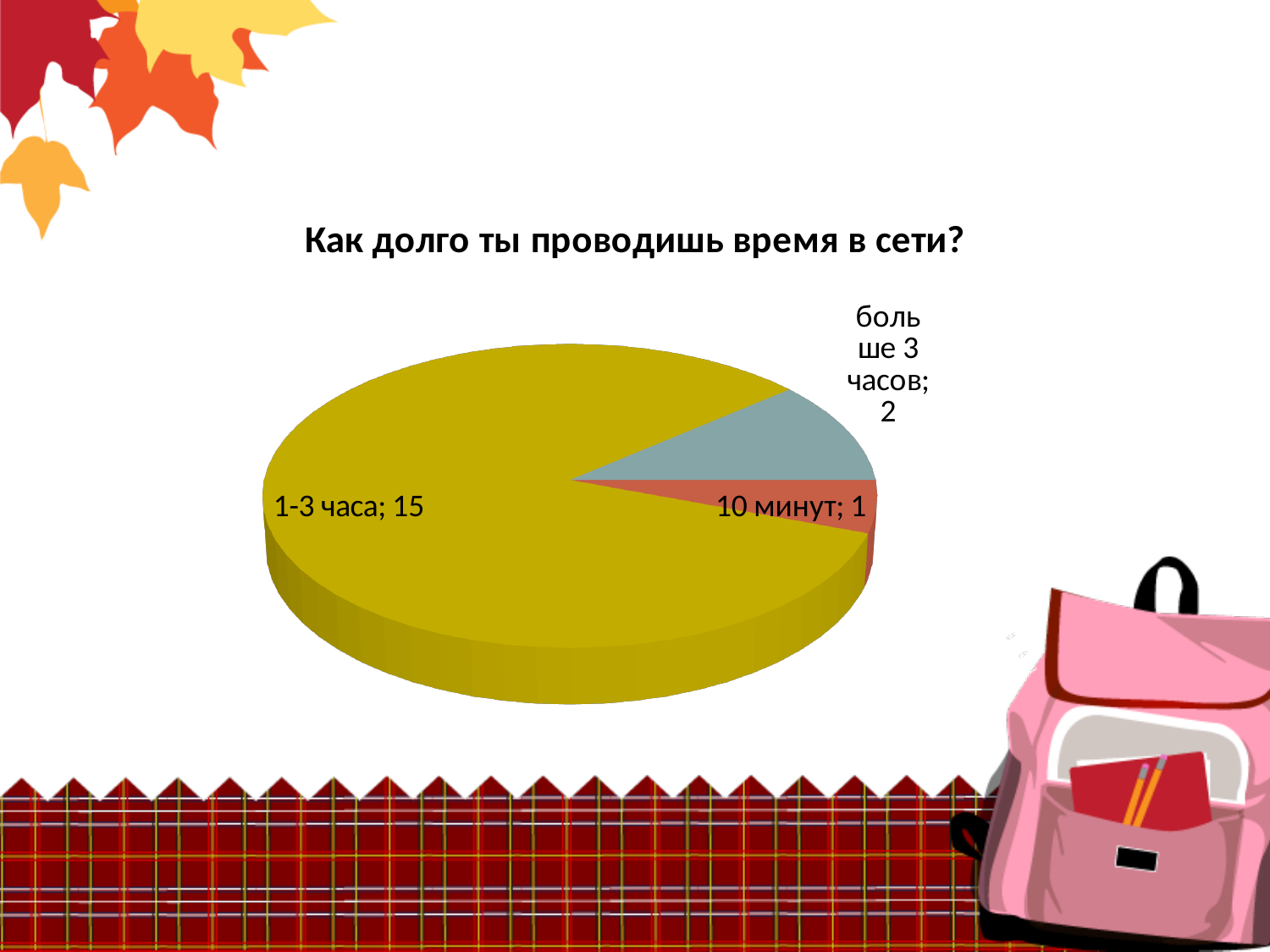
What is the value for "больше 3 часов"? 2 Which category has the largest slice? 1-3 часа What kind of chart is shown on the slide? pie chart What is the value for "10 минут"? 1 What colour is the "1-3 часа" slice? yellow Which is larger, the value for "больше 3 часов" or the value for "10 минут"? больше 3 часов Which category has the smallest slice? 10 минут How many slices does the pie chart have? 3 What is the value for "1-3 часа"? 15 What is the total of all slices in the pie chart? 18 What is the difference between the values for "1-3 часа" and "больше 3 часов"? 13 What is the title of the chart? Как долго ты проводишь время в сети?